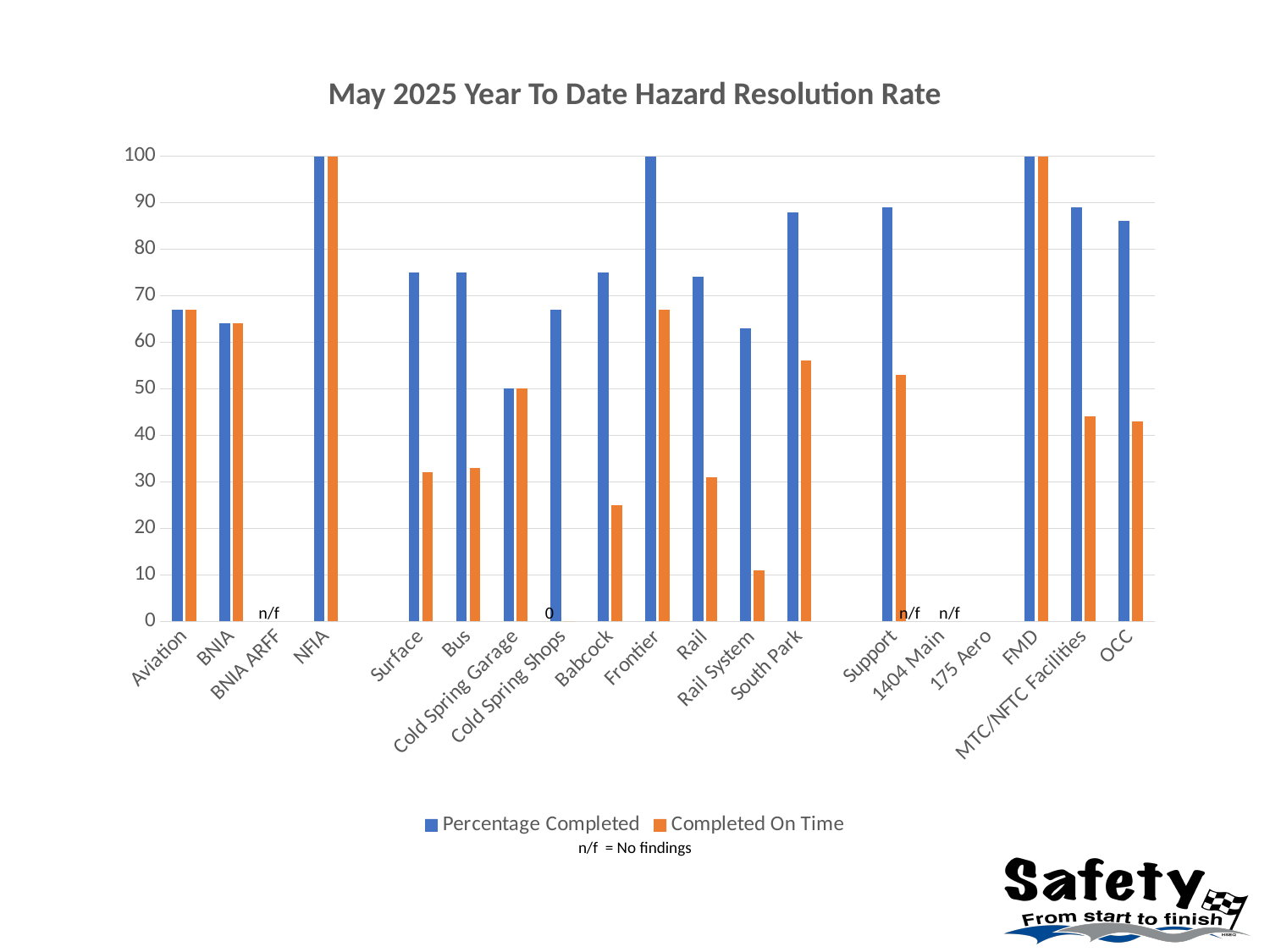
Which is larger, the Percentage Completed value for Frontier or for Rail? Frontier What is the Percentage Completed value for NFIA? 100 How many categories are listed on the x axis? 19 What kind of chart is shown on the slide? Bar chart Is the Completed On Time value for Surface greater or less than 40? less What is the Completed On Time value for Cold Spring Shops? 0 What is the Completed On Time value for FMD? 100 What is the title of the chart? May 2025 Year To Date Hazard Resolution Rate Is the Completed On Time value for Rail System greater or less than 20? less What is the Percentage Completed value for Cold Spring Garage? 50 How many series does the legend list? 2 Is the Percentage Completed value for South Park greater or less than 80? greater